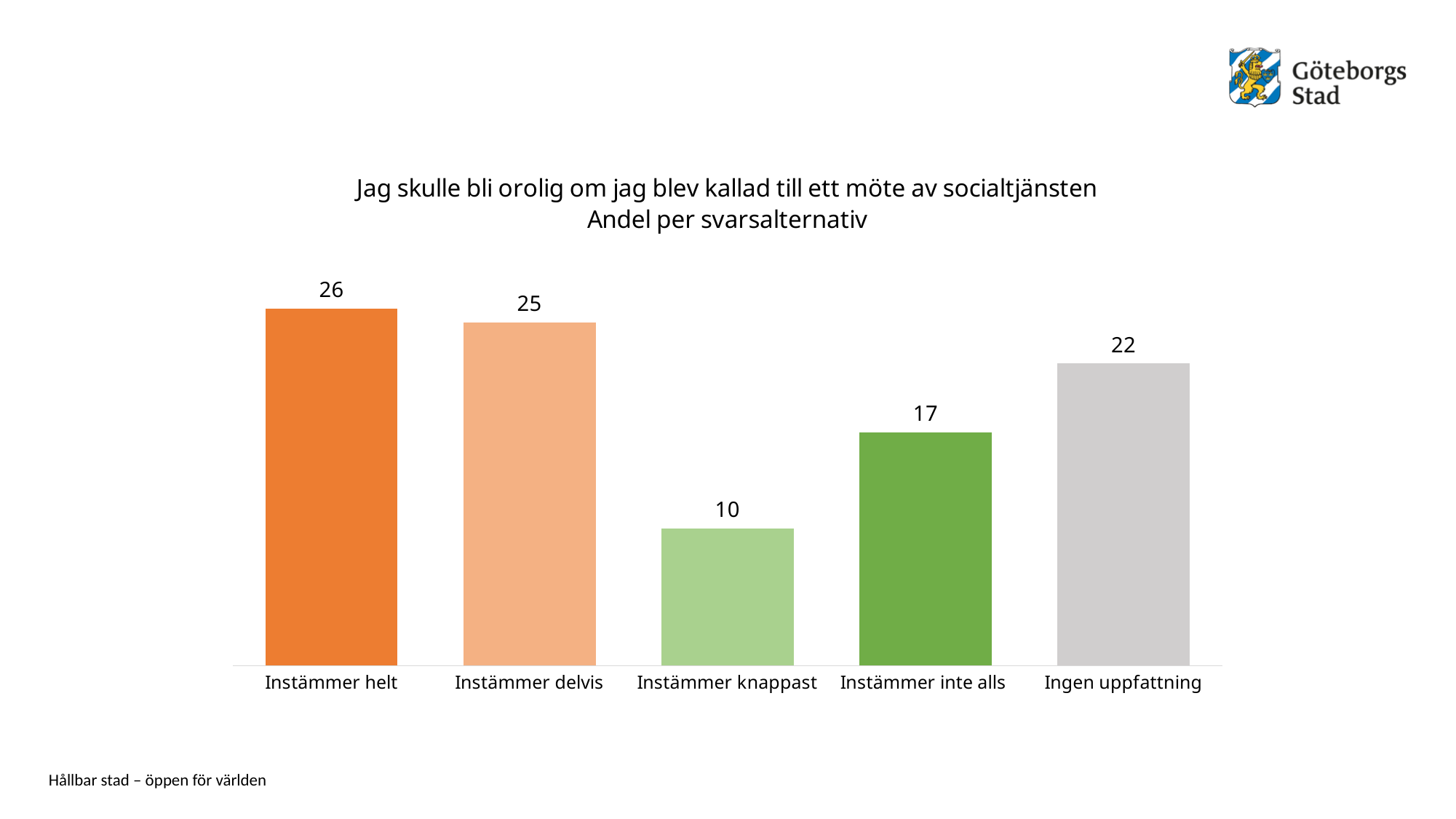
What is the difference between the values for Instämmer helt and Instämmer knappast? 16 Which category has the highest value? Instämmer helt Which category has the lowest value? Instämmer knappast What is the value for Instämmer inte alls? 17 What is the value for Instämmer helt? 26 Which is larger, the value for Instämmer delvis or the value for Ingen uppfattning? Instämmer delvis What kind of chart is shown on the slide? Bar chart How many categories are shown on the x axis? 5 What is the first line of the chart title? Jag skulle bli orolig om jag blev kallad till ett möte av socialtjänsten What is the difference between the values for Ingen uppfattning and Instämmer inte alls? 5 What is the value for Ingen uppfattning? 22 What is the value for Instämmer knappast? 10